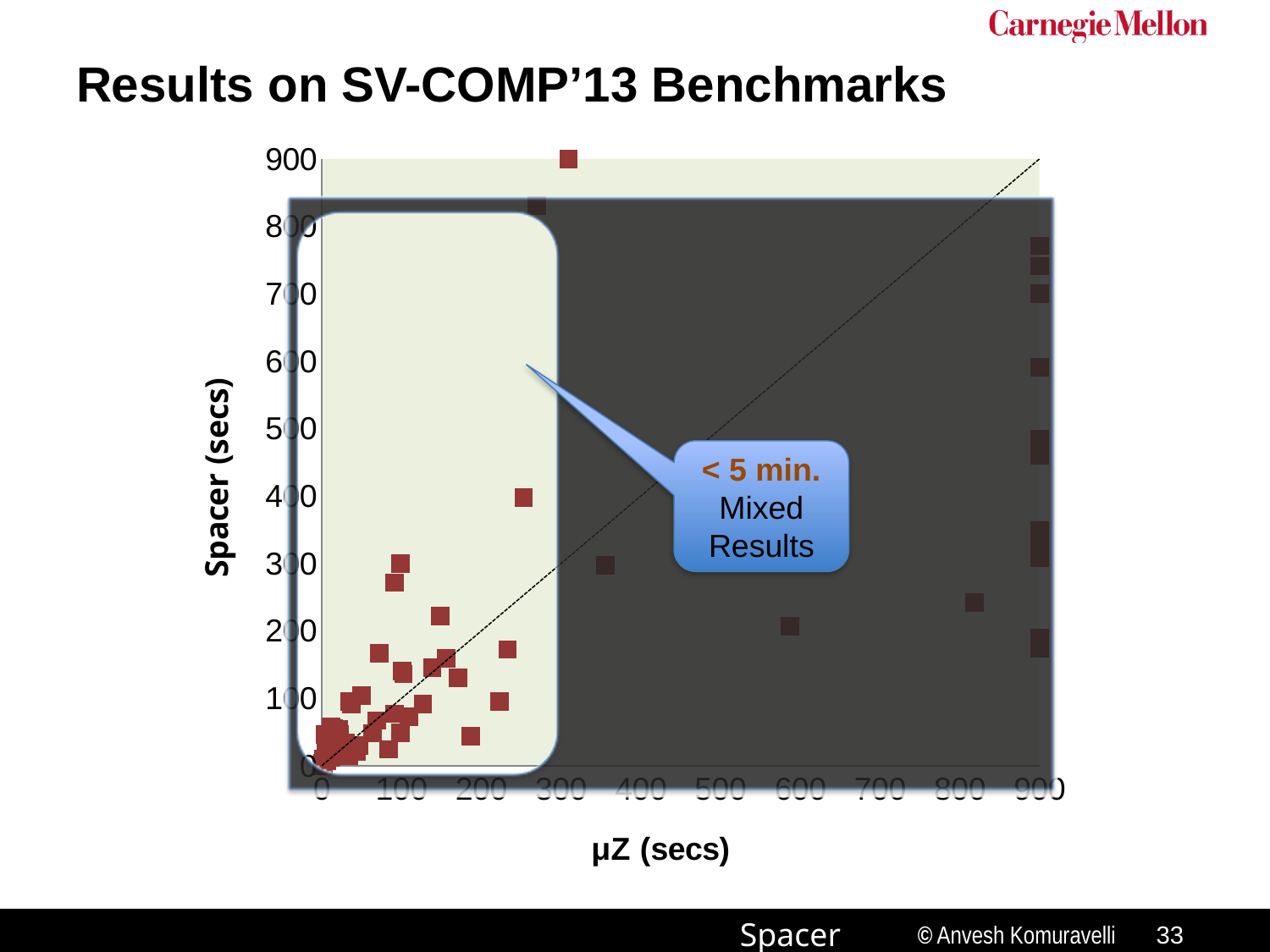
What is the label of the horizontal axis of the chart? μZ (secs) What kind of chart is shown on the slide? scatter plot What is the label of the vertical axis of the chart? Spacer (secs) Is the Spacer value of the highest plotted point greater or less than 800? greater Is the μZ value of the rightmost plotted points greater or less than 800? greater